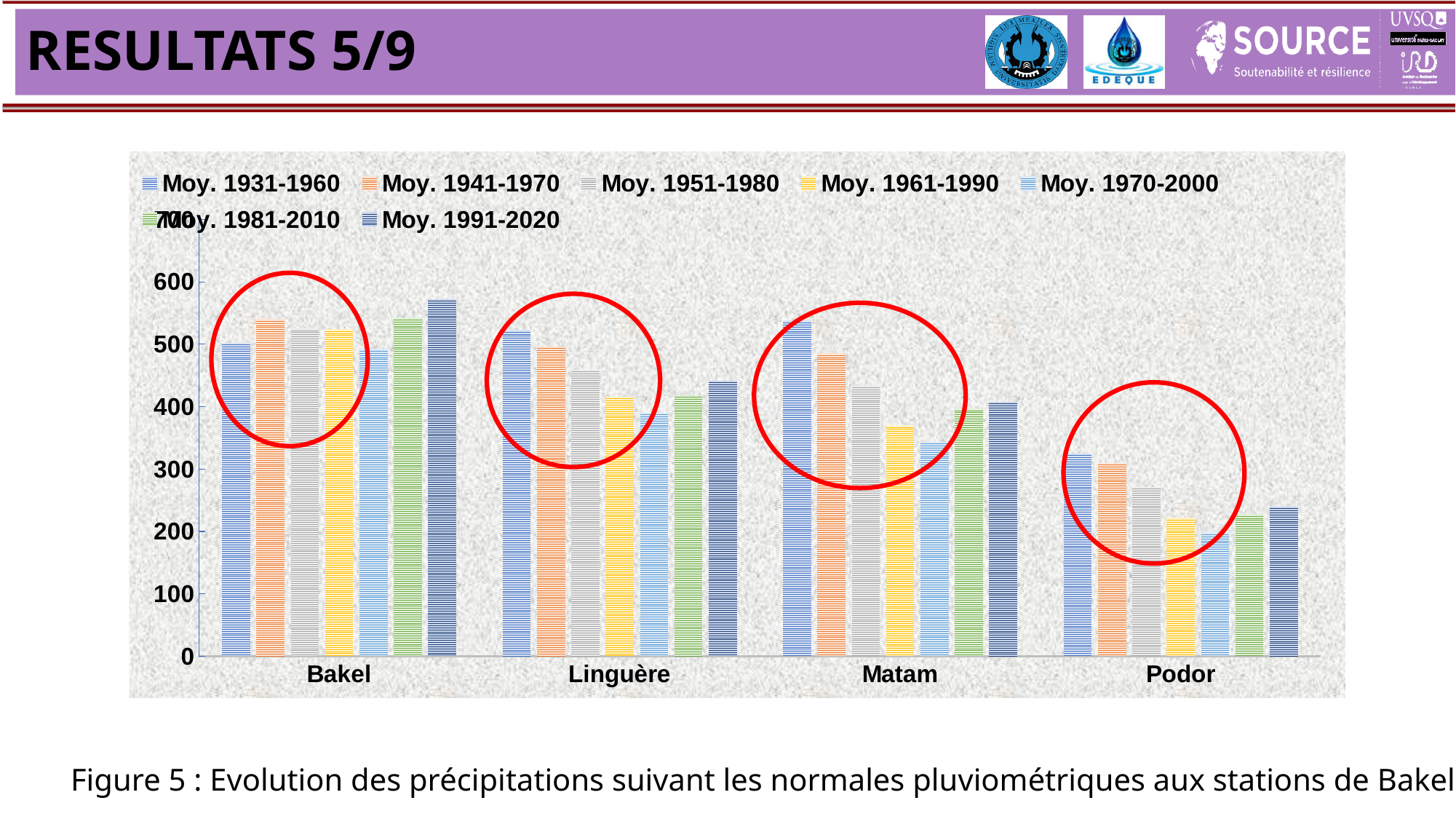
Is the value for Moy. 1970-2000 at Linguère greater or less than 300? greater Is the value for Moy. 1961-1990 at Podor greater or less than 300? less How many stations (categories) are shown on the x axis of the chart? 4 Is the value for Moy. 1931-1960 at Podor greater or less than 400? less Which station has the highest Moy. 1991-2020 value? Bakel At Matam, which is larger: the Moy. 1931-1960 value or the Moy. 1970-2000 value? Moy. 1931-1960 How many series does the chart's legend list? 7 Which station has the lowest Moy. 1931-1960 value? Podor What kind of chart is shown on the slide? bar chart Which is larger: the Moy. 1991-2020 value at Bakel or at Podor? Bakel